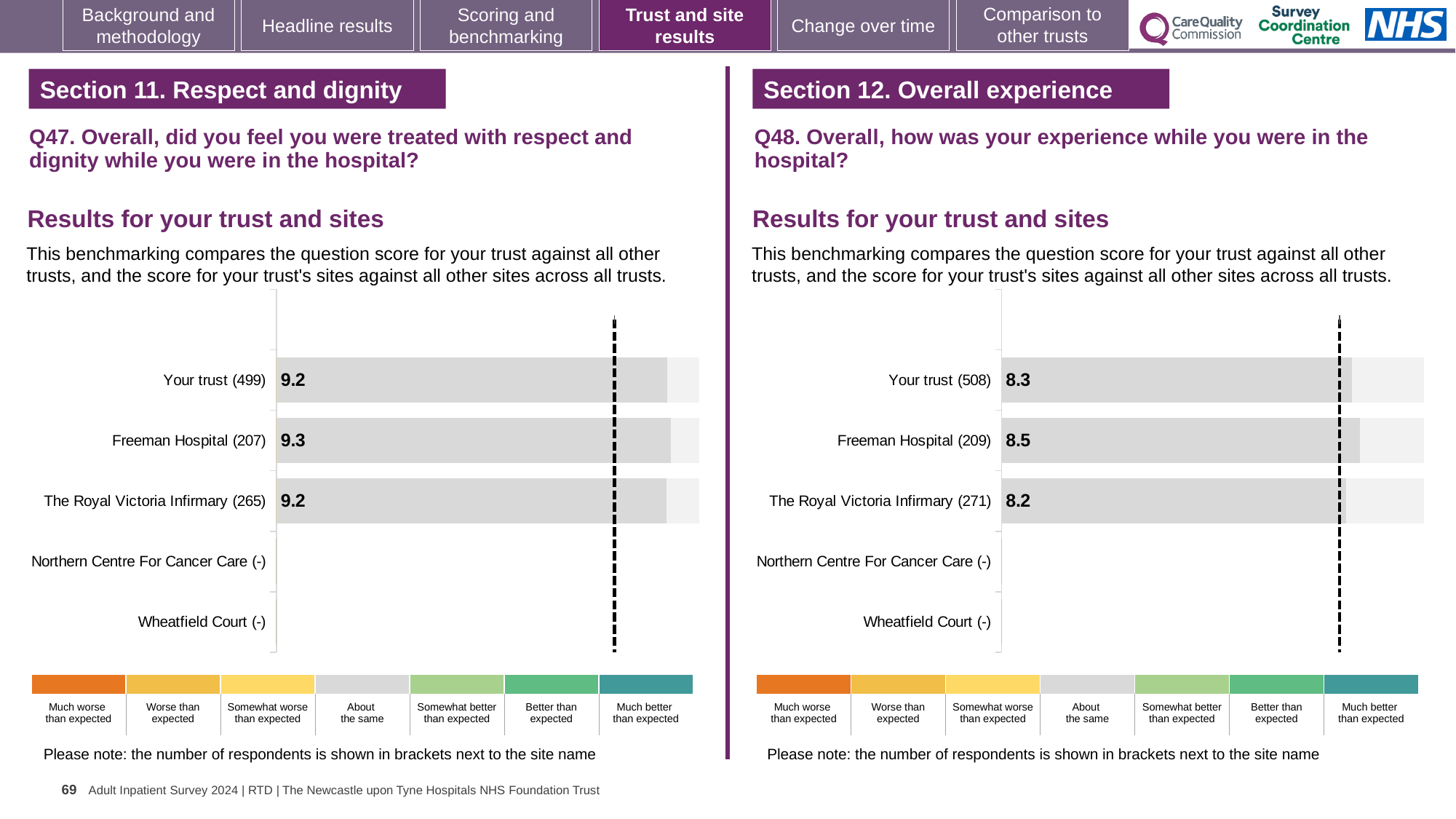
On the Q48 chart (Section 12. Overall experience), what is the score for Your trust? 8.3 On the Q47 chart (Section 11. Respect and dignity), what is the score for Your trust? 9.2 On the Q47 chart (Section 11. Respect and dignity), which has the higher score, Freeman Hospital or The Royal Victoria Infirmary? Freeman Hospital On the Q48 chart (Section 12. Overall experience), what is the difference between the scores for Freeman Hospital and The Royal Victoria Infirmary? 0.3 How many respondents are shown in brackets for Your trust on the Q48 chart (Section 12. Overall experience)? 508 On the Q48 chart (Section 12. Overall experience), which of the sites with a score shown has the lowest score? The Royal Victoria Infirmary On the Q48 chart (Section 12. Overall experience), what is the score for The Royal Victoria Infirmary? 8.2 On the Q48 chart (Section 12. Overall experience), which site has the highest score? Freeman Hospital How many site/trust categories are listed on the Q47 chart (Section 11. Respect and dignity)? 5 How many categories does the colour legend below the Q48 chart (Section 12. Overall experience) list? 7 On the Q47 chart (Section 11. Respect and dignity), what is the score for Freeman Hospital? 9.3 What kind of chart is used on the Q47 chart (Section 11. Respect and dignity)? Bar chart